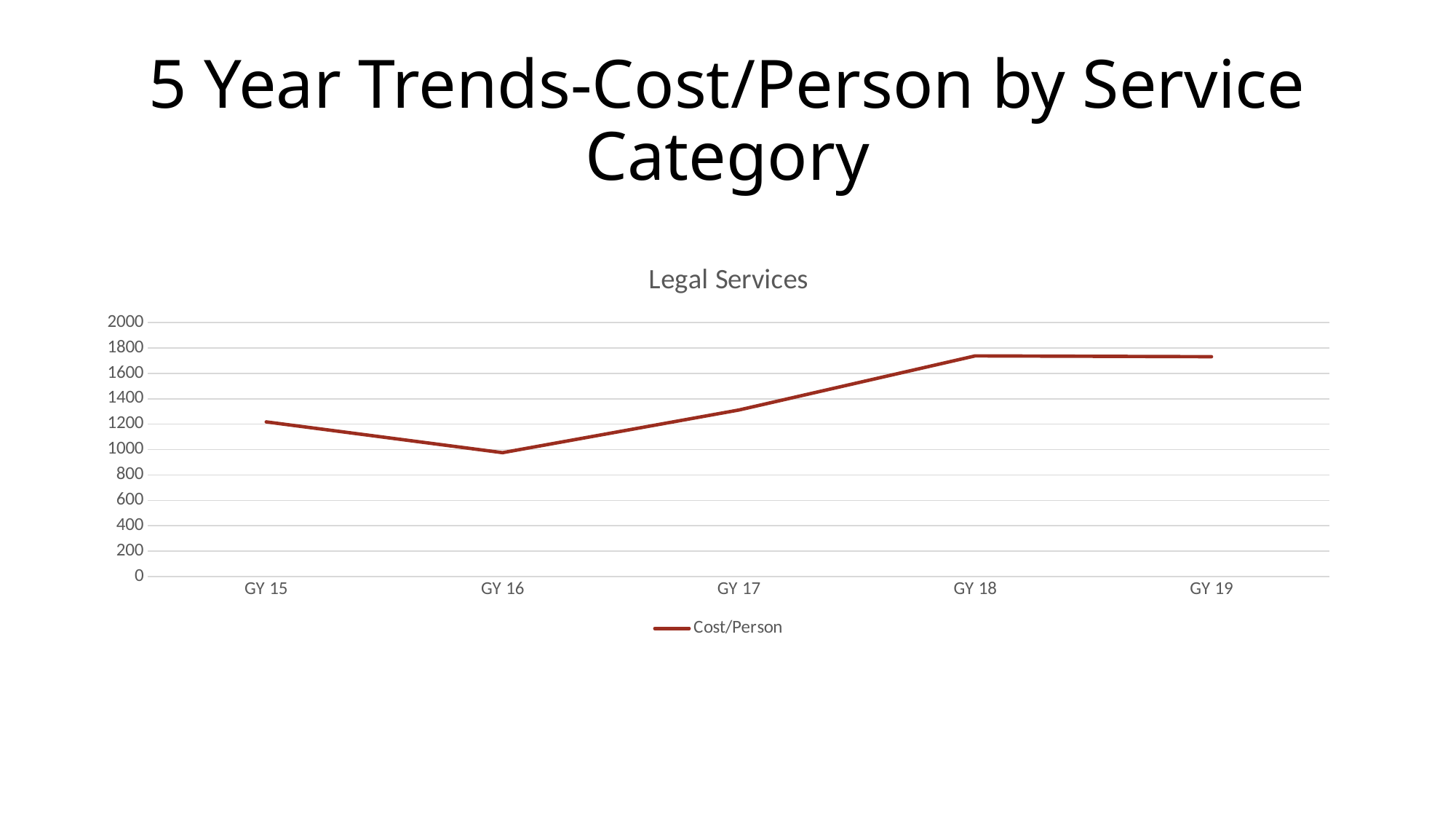
Is the Cost/Person for GY 16 greater or less than 1200? less Which year has the lowest Cost/Person? GY 16 What is the name of the series shown in the legend? Cost/Person Is the Cost/Person for GY 18 greater or less than 1600? greater What kind of chart is shown on the slide? line chart How many series does the legend list? 1 Which has the larger Cost/Person, GY 16 or GY 17? GY 17 Is the Cost/Person for GY 17 greater or less than 1200? greater What is the title of the chart? Legal Services Does the Cost/Person rise or fall from GY 16 to GY 18? rise How many years are plotted on the x axis? 5